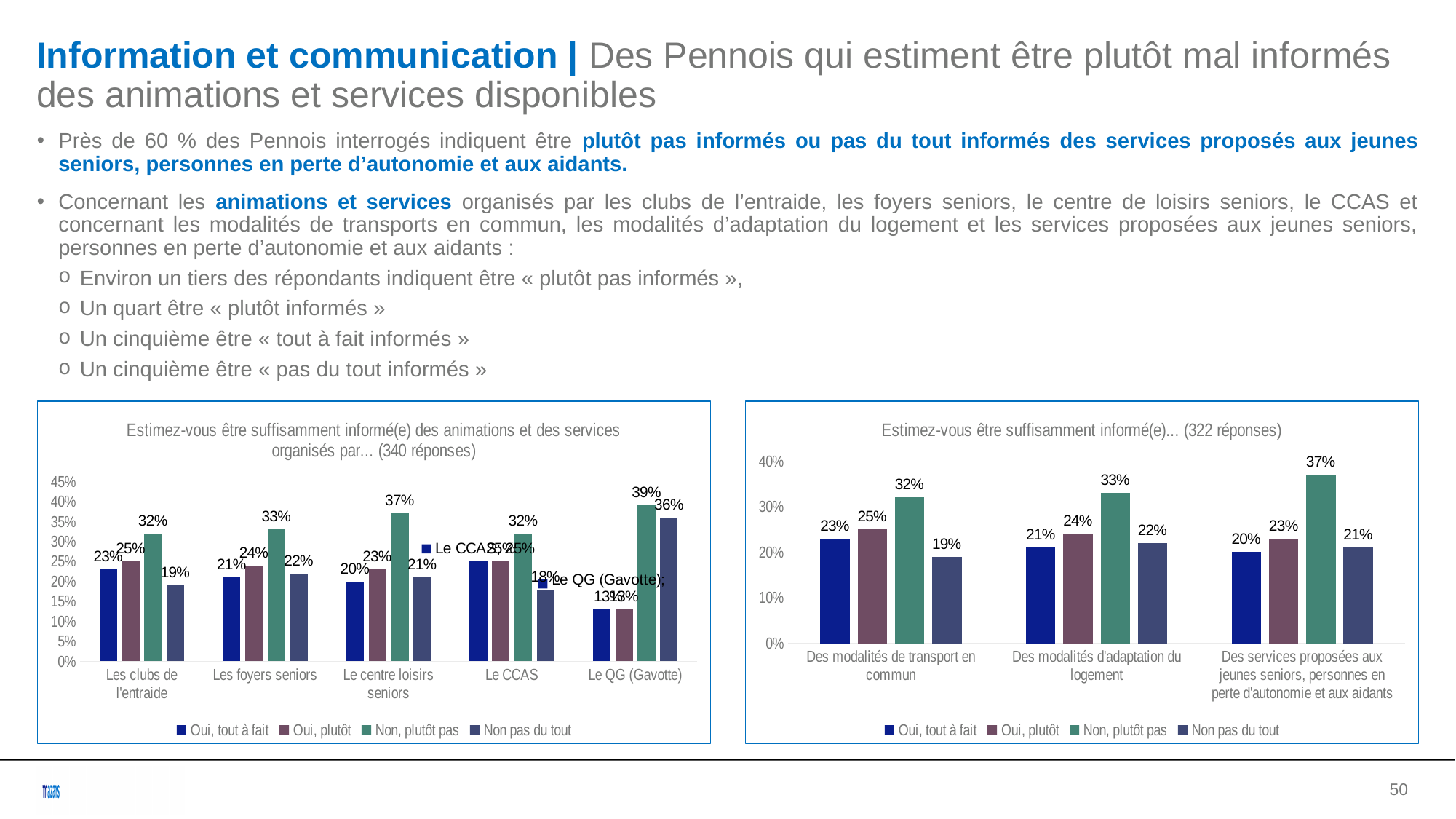
In the left chart (340 réponses), what is the value for "Non pas du tout" for Le QG (Gavotte)? 36% In the left chart (340 réponses), what is the difference between the "Non, plutôt pas" and "Oui, tout à fait" values for Les foyers seniors? 12% How many series does the legend of the right chart (322 réponses) list? 4 What type of chart is the right chart (322 réponses)? Bar chart In the right chart (322 réponses), what is the difference between the "Non, plutôt pas" value for Des services proposées aux jeunes seniors and the "Non, plutôt pas" value for Des modalités de transport en commun? 5% In the right chart (322 réponses), what is the "Oui, plutôt" value for Des modalités d'adaptation du logement? 24% In the right chart (322 réponses), what is the "Non, plutôt pas" value for Des services proposées aux jeunes seniors, personnes en perte d'autonomie et aux aidants? 37% In the right chart (322 réponses), which is larger for Des modalités de transport en commun: "Oui, tout à fait" or "Non pas du tout"? Oui, tout à fait In the left chart (340 réponses), which category has the lowest "Oui, tout à fait" value? Le QG (Gavotte) How many categories are shown on the x axis of the left chart (340 réponses)? 5 In the left chart (340 réponses), what percentage of respondents answered "Non, plutôt pas" for Le centre loisirs seniors? 37% In the left chart (340 réponses), which category has the highest "Non, plutôt pas" value? Le QG (Gavotte)